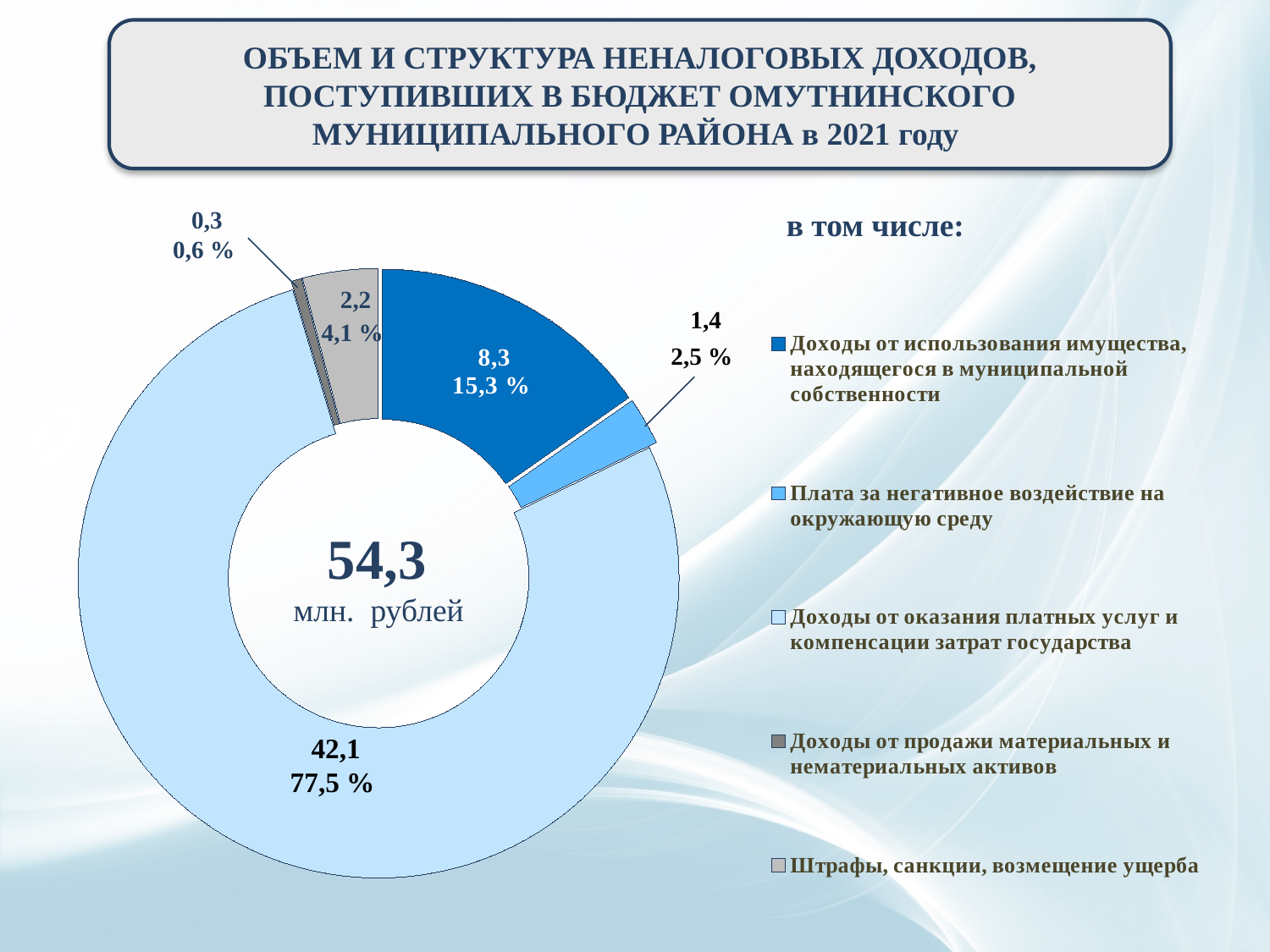
Какова сумма платы за негативное воздействие на окружающую среду? 1,4 Какова сумма доходов от использования имущества, находящегося в муниципальной собственности? 8,3 Какую долю составляют штрафы, санкции, возмещение ущерба? 4,1 % Какой общий объём неналоговых доходов указан в центре диаграммы? 54,3 млн. рублей Сколько категорий доходов показано на диаграмме? 5 Какая доля соответствует доходам от продажи материальных и нематериальных активов? 0,6 % Какая категория имеет наибольшую долю в структуре неналоговых доходов? Доходы от оказания платных услуг и компенсации затрат государства Какую долю составляют доходы от оказания платных услуг и компенсации затрат государства? 77,5 % На сколько доходы от использования имущества больше штрафов, санкций, возмещения ущерба (в млн. рублей)? 6,1 Какой тип диаграммы показан на слайде? кольцевая (круговая) диаграмма Что больше: плата за негативное воздействие на окружающую среду или штрафы, санкции, возмещение ущерба? Штрафы, санкции, возмещение ущерба Какая категория имеет наименьшую долю в структуре неналоговых доходов? Доходы от продажи материальных и нематериальных активов